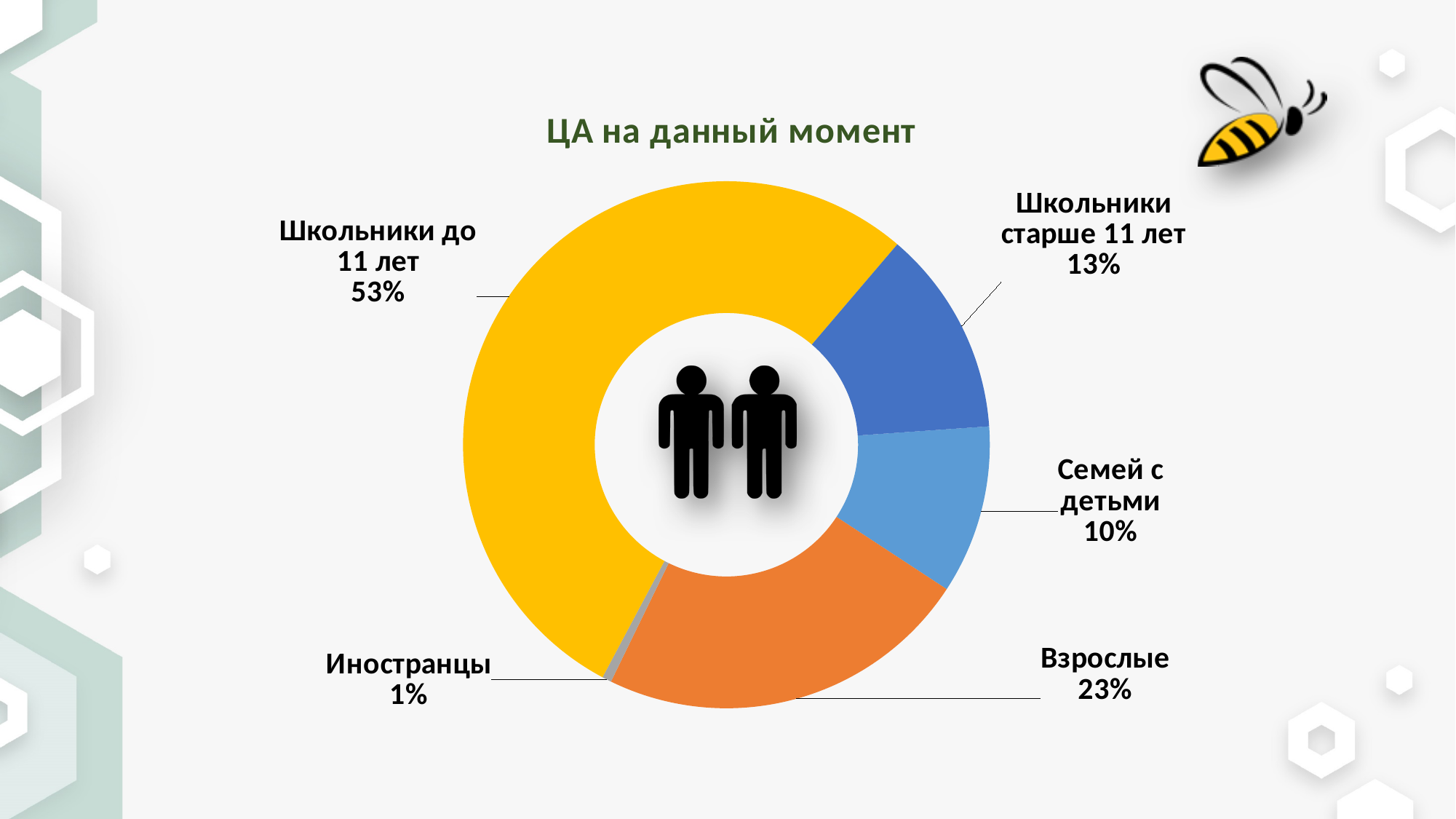
Which is larger, the share for "Школьники старше 11 лет" or for "Семей с детьми"? Школьники старше 11 лет What is the value shown for "Взрослые"? 23% What kind of chart is shown on the slide? Doughnut (pie) chart What is the difference between the shares of "Школьники до 11 лет" and "Взрослые"? 30% What is the value shown for "Школьники старше 11 лет"? 13% What is the title of the chart? ЦА на данный момент How many categories are shown in the chart? 5 What is the value shown for "Иностранцы"? 1% What share of the chart does "Школьники до 11 лет" represent? 53% Which category has the largest share of the chart? Школьники до 11 лет What is the value shown for "Семей с детьми"? 10% Which category has the smallest share of the chart? Иностранцы